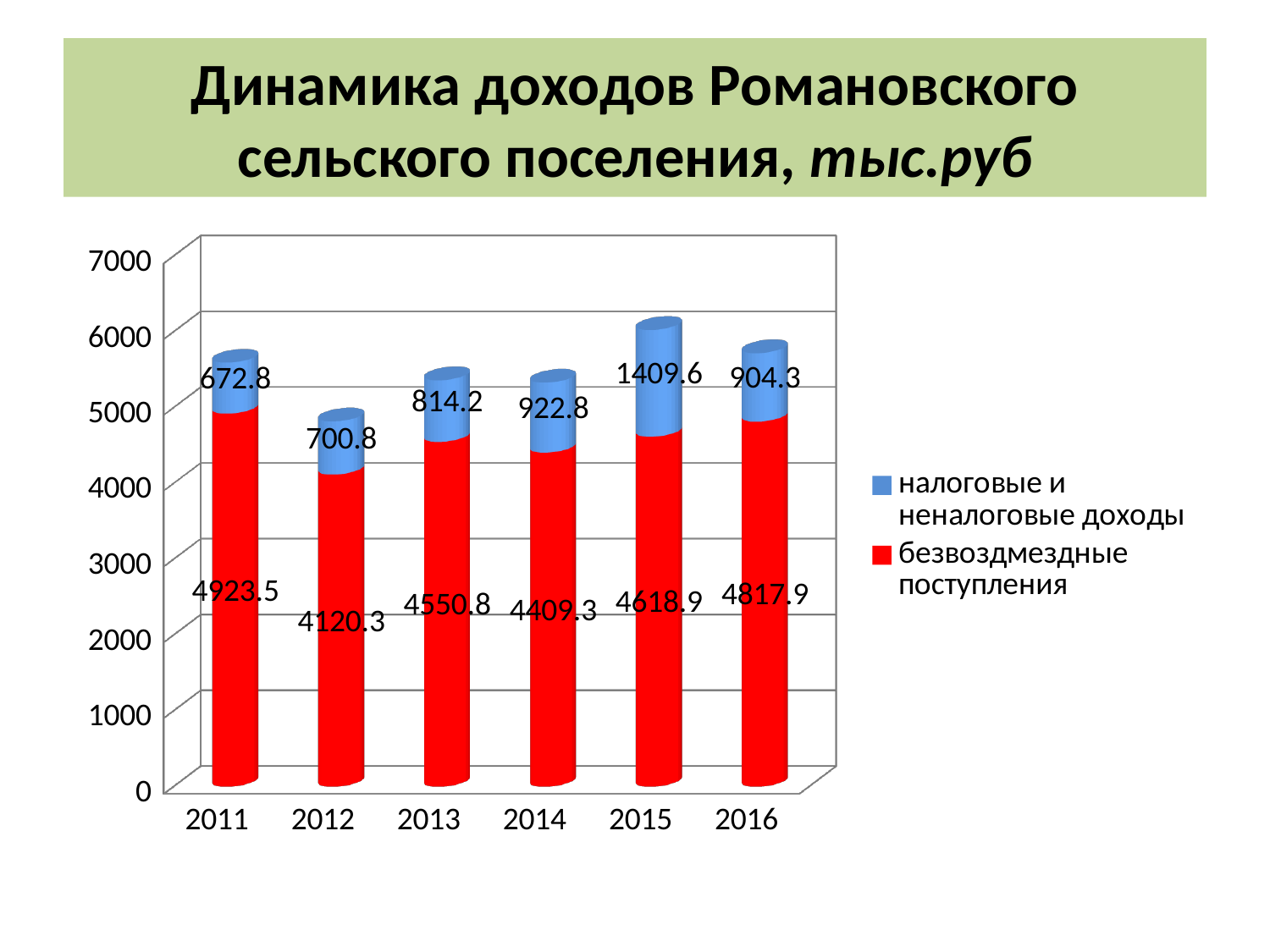
Which is larger: налоговые и неналоговые доходы in 2013 or in 2014? 2014 Which year has the lowest value of безвозмездные поступления? 2012 What is the total of the stacked bar for 2012? 4821.1 How many series does the legend list? 2 What is the value of безвозмездные поступления for 2014? 4409.3 What is the total of the stacked bar for 2015? 6028.5 What is the difference between безвозмездные поступления in 2016 and in 2012? 697.6 Which year has the highest value of налоговые и неналоговые доходы? 2015 What is the value of безвозмездные поступления for 2011? 4923.5 What kind of chart is shown on the slide? Stacked bar chart How many years are shown on the x axis? 6 What is the value of налоговые и неналоговые доходы for 2015? 1409.6